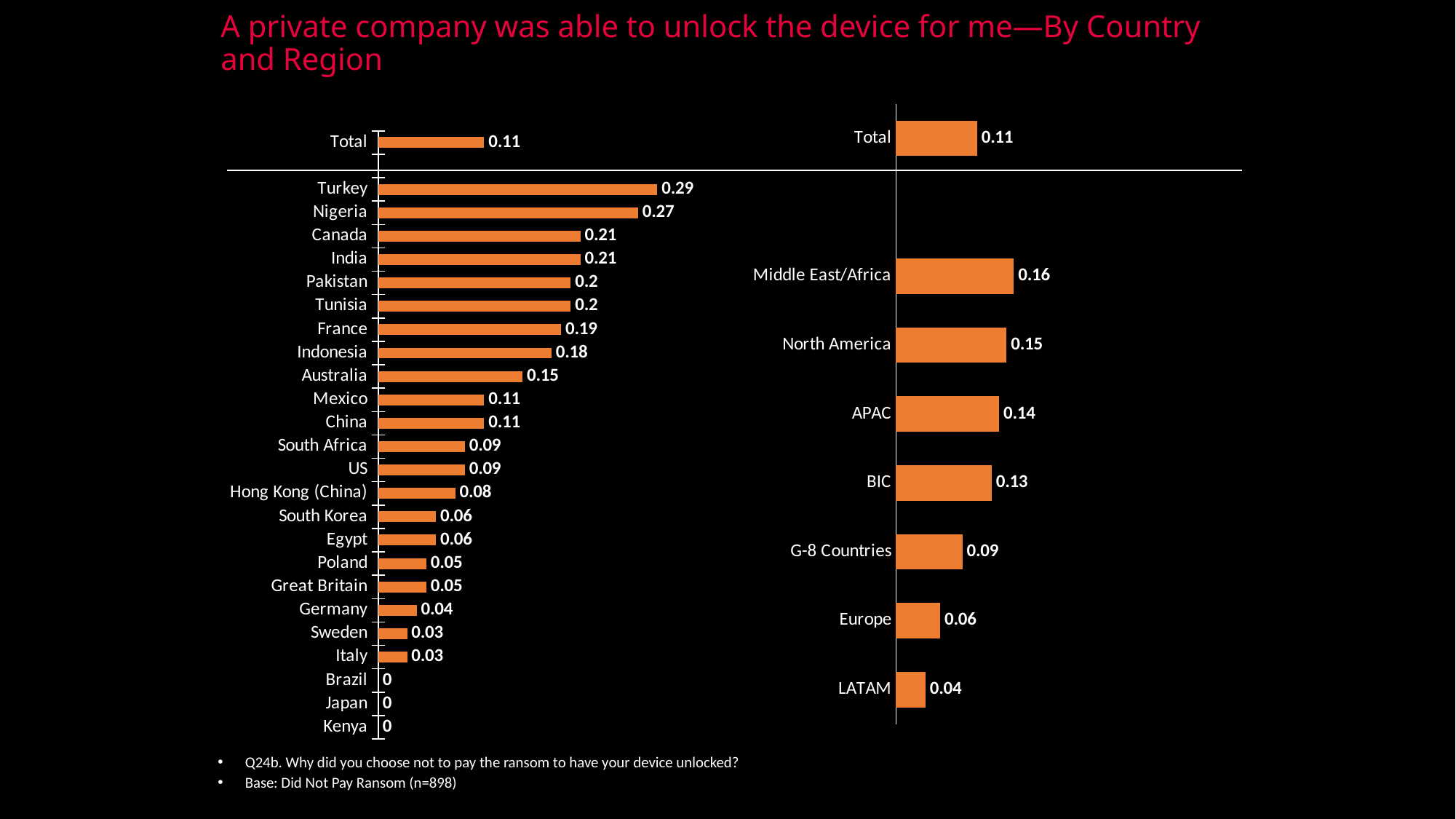
In the right chart (by region), what is the value for Middle East/Africa? 0.16 In the right chart (by region), which is larger, the value for APAC or the value for G-8 Countries? APAC What type of chart is used on this slide? Bar chart In the left chart (by country), how many countries have a value of 0? 3 In the left chart (by country), what is the value for Hong Kong (China)? 0.08 In the right chart (by region), which region has the lowest value? LATAM In the right chart (by region), what is the difference between the values for North America and Europe? 0.09 In the left chart (by country), which is larger, the value for Australia or the value for Indonesia? Indonesia In the left chart (by country), what is the value for Turkey? 0.29 In the right chart (by region), how many regions are shown below the Total bar? 7 In the left chart (by country), what is the difference between the values for Turkey and Nigeria? 0.02 In the left chart (by country), which country has the highest value? Turkey